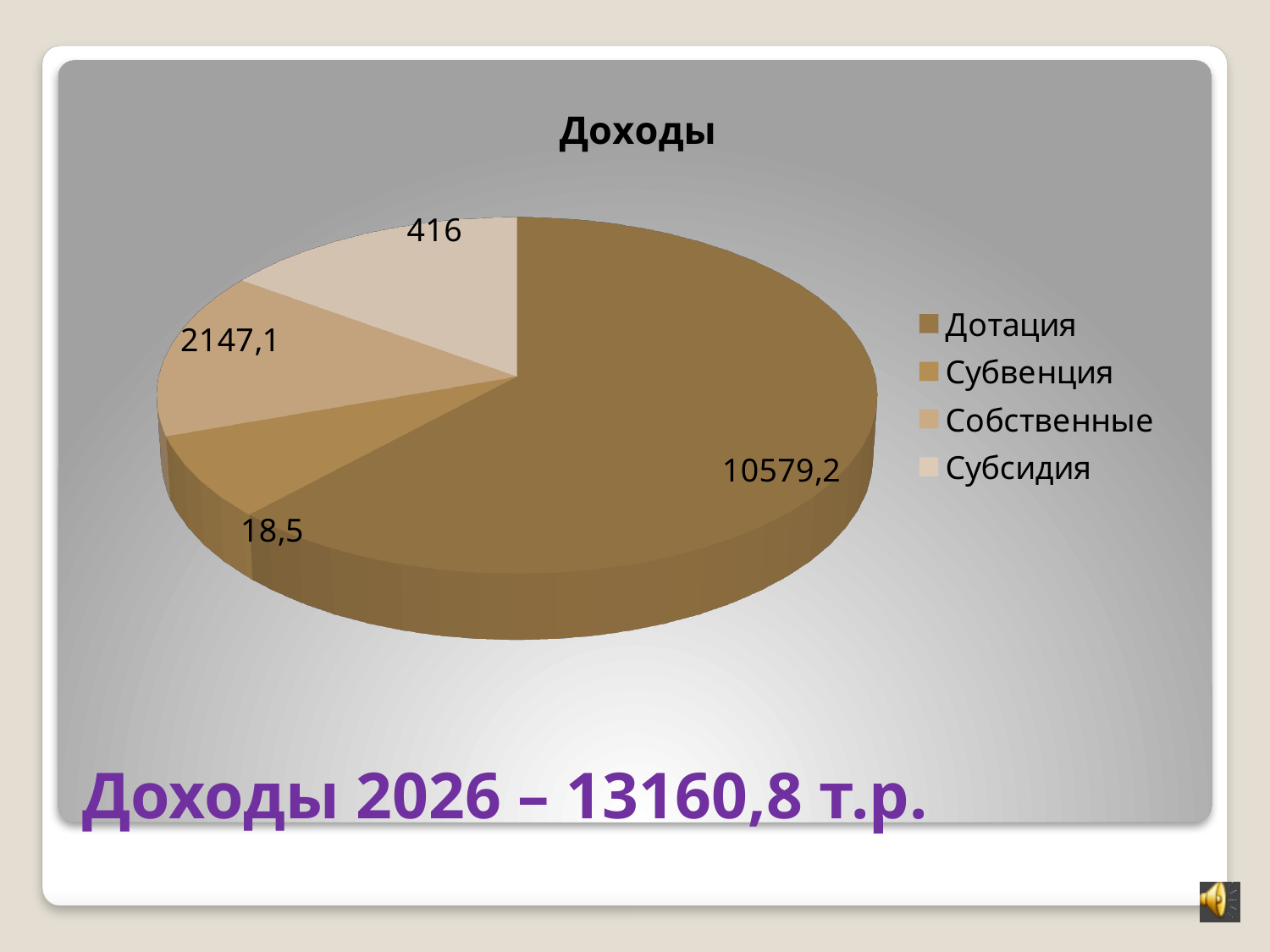
What is the difference between the values for Дотация and Собственные in the Доходы pie chart? 8432,1 What is the difference between the values for Собственные and Субсидия in the Доходы pie chart? 1731,1 What is the title of the chart on the slide? Доходы Which category has the smallest slice in the Доходы pie chart? Субвенция Which is larger in the Доходы pie chart, Субсидия or Собственные? Собственные What is the value for Собственные in the Доходы pie chart? 2147,1 What is the value for Дотация in the Доходы pie chart? 10579,2 What is the value for Субсидия in the Доходы pie chart? 416 How many slices does the Доходы pie chart have? 4 What type of chart is shown on the slide? Pie chart Which category has the largest slice in the Доходы pie chart? Дотация What is the value for Субвенция in the Доходы pie chart? 18,5